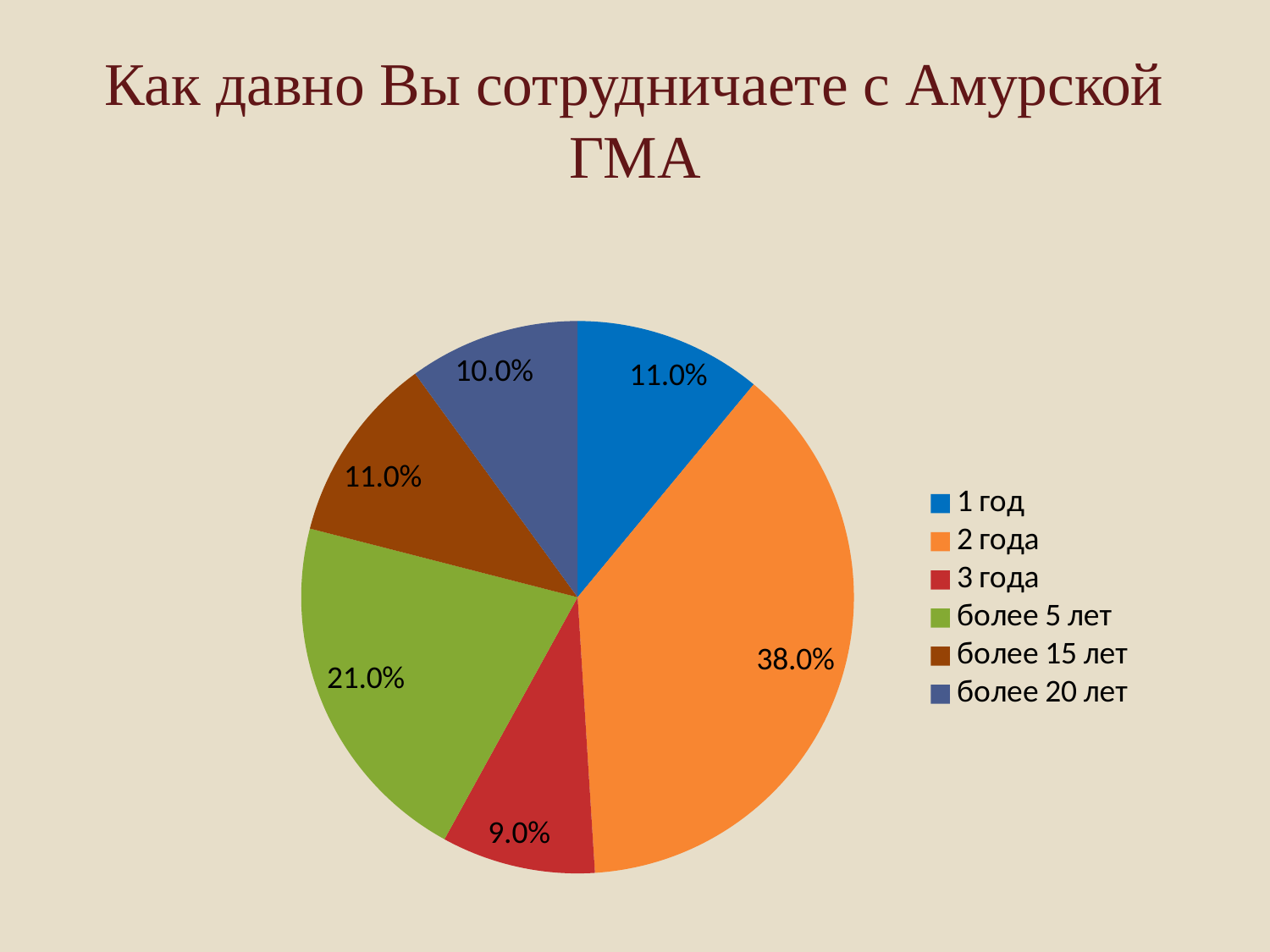
How many categories does the legend list? 6 Which category has the largest slice? 2 года Which is larger, the value for "более 5 лет" or the value for "более 15 лет"? более 5 лет What is the title of the chart on the slide? Как давно Вы сотрудничаете с Амурской ГМА What kind of chart is shown on the slide? pie chart What is the value for "1 год"? 11.0% What is the value for "3 года"? 9.0% What share of the pie does the "2 года" slice have? 38.0% What is the value for "более 20 лет"? 10.0% What is the value for "более 5 лет"? 21.0% Which category has the smallest slice? 3 года What is the difference between the values for "2 года" and "более 5 лет"? 17.0%